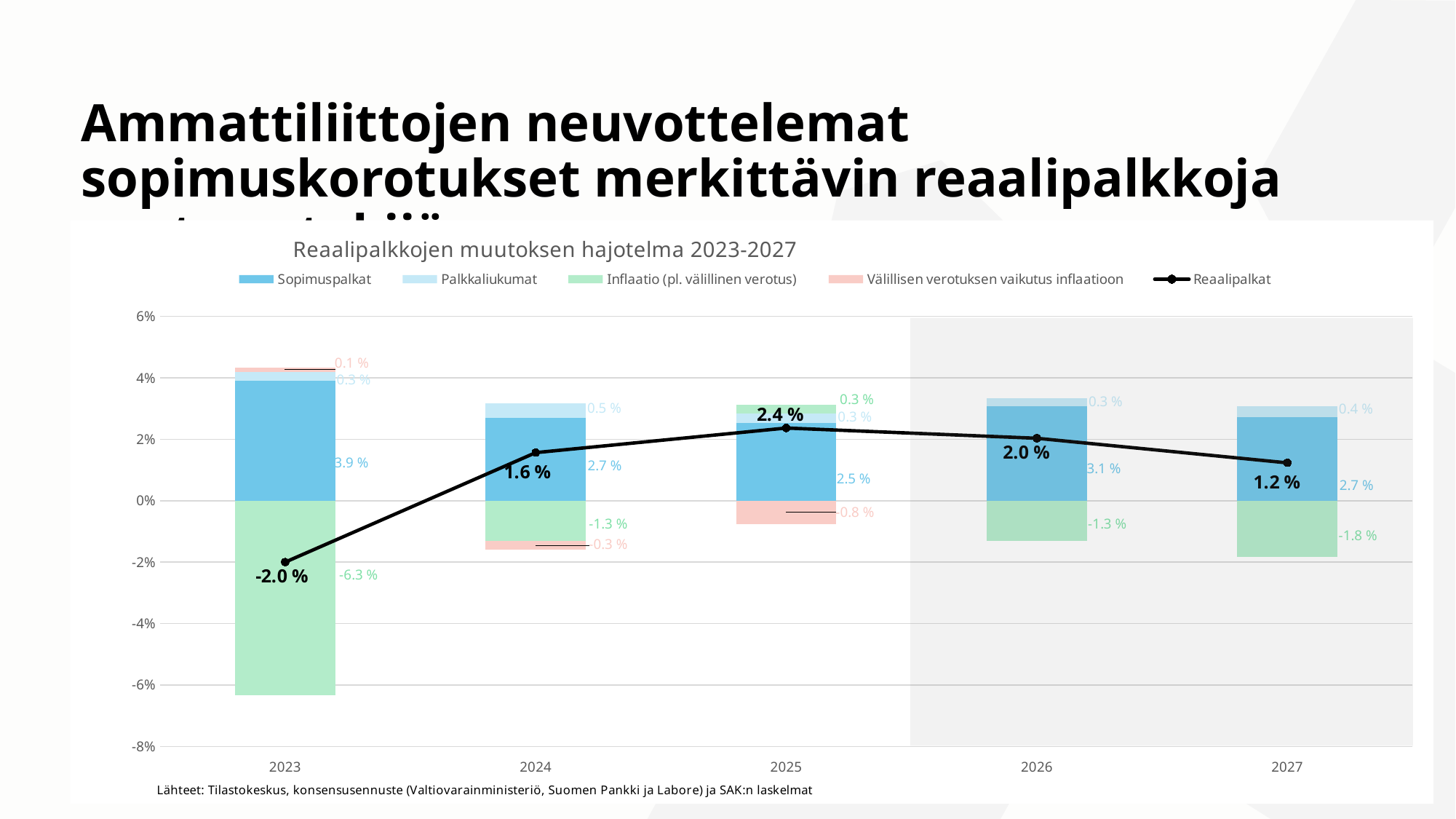
What is the Palkkaliukumat value for 2024? 0.5 % What kind of chart is this? Stacked bar chart with a line Which year has the larger Sopimuspalkat value, 2023 or 2025? 2023 What is the difference between the Sopimuspalkat values for 2026 and 2027? 0.4 % What is the Sopimuspalkat value for 2023? 3.9 % What is the value of Reaalipalkat in 2025? 2.4 % In which year is Reaalipalkat lowest? 2023 What is the title of the chart? Reaalipalkkojen muutoksen hajotelma 2023-2027 How many years are shown on the x axis? 5 How many series does the legend list? 5 In which year is Reaalipalkat highest? 2025 What is the Inflaatio (pl. välillinen verotus) value for 2027? -1.8 %